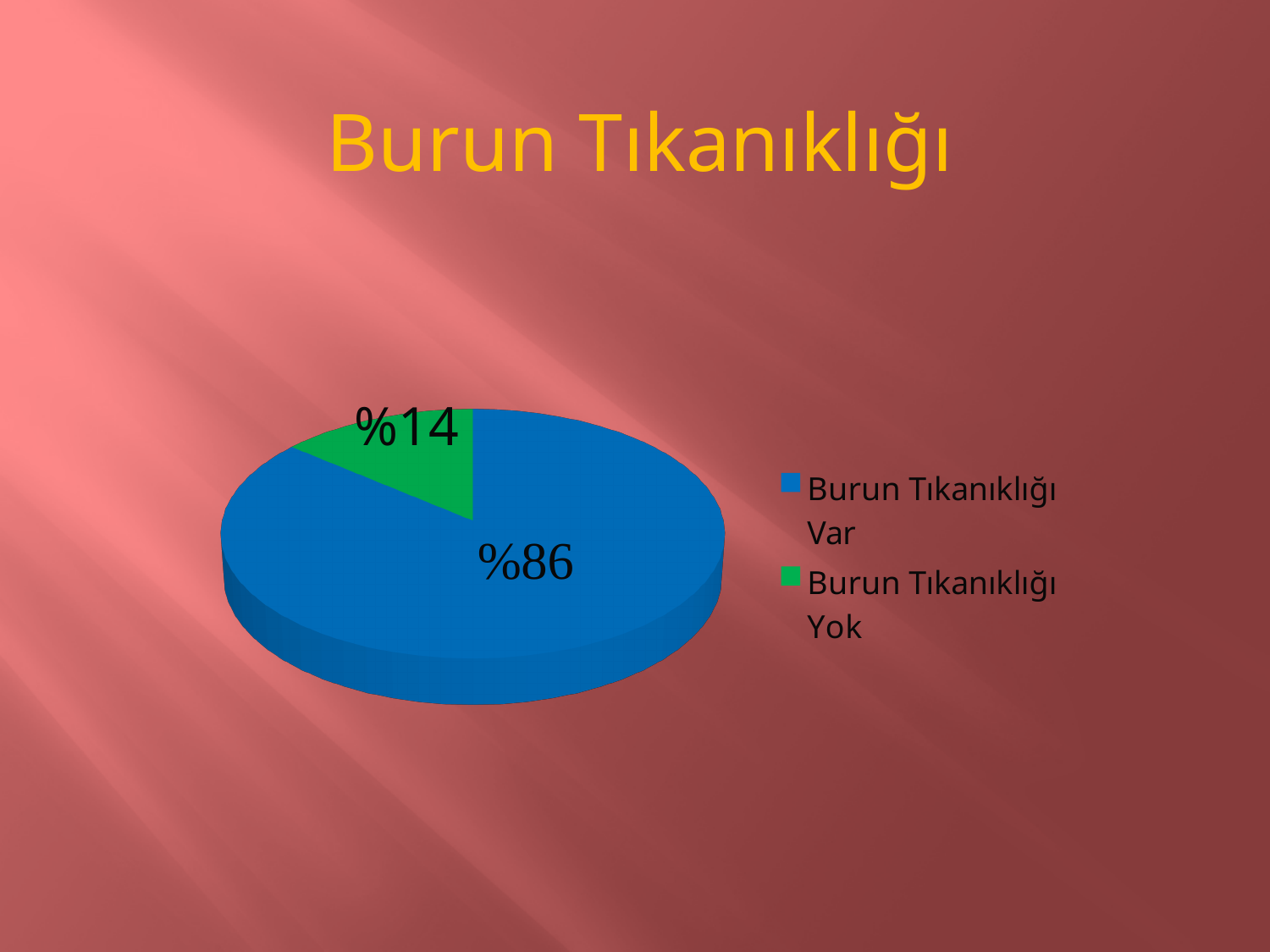
What colour is the slice for "Burun Tıkanıklığı Yok"? green Which slice of the pie is the smallest? Burun Tıkanıklığı Yok How many entries does the legend list? 2 How many slices does the pie chart have? 2 What is the title of the slide? Burun Tıkanıklığı What share of the pie does "Burun Tıkanıklığı Yok" represent? %14 What is the value shown for "Burun Tıkanıklığı Yok"? %14 What kind of chart is shown on the slide? pie chart Which is larger: "Burun Tıkanıklığı Var" or "Burun Tıkanıklığı Yok"? Burun Tıkanıklığı Var What is the value shown for "Burun Tıkanıklığı Var"? %86 Which slice of the pie is the largest? Burun Tıkanıklığı Var What is the difference between the values for "Burun Tıkanıklığı Var" and "Burun Tıkanıklığı Yok"? %72